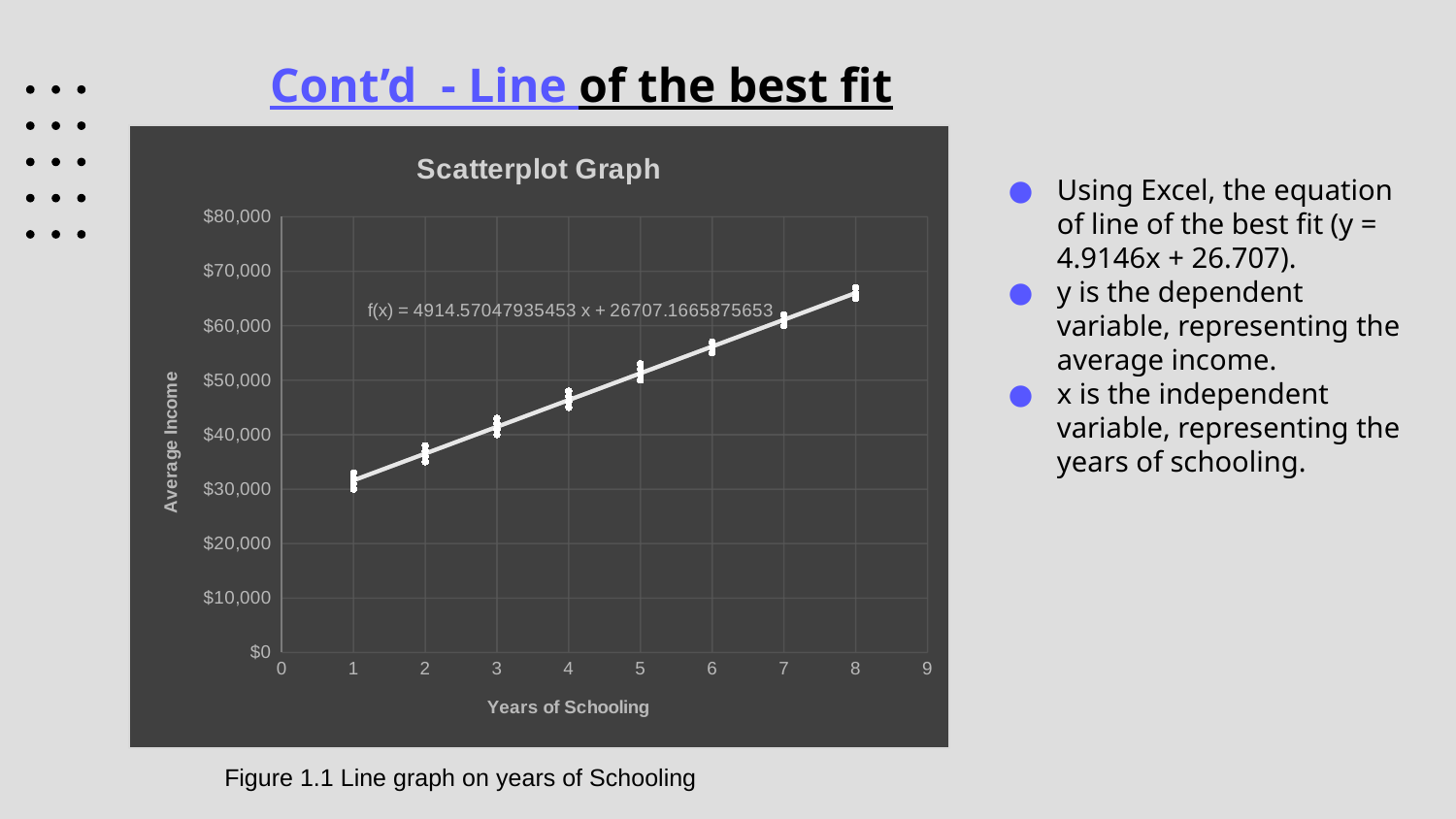
What kind of chart is shown on the slide? scatter chart Is the average income at 2 years of schooling greater or less than $40,000? less Do the values rise or fall as years of schooling increase? rise At which number of years of schooling is the average income lowest? 1 What is the title of the chart? Scatterplot Graph Which has the higher average income: 3 years of schooling or 7 years of schooling? 7 years of schooling Is the average income at 6 years of schooling greater or less than $60,000? less Is the average income at 8 years of schooling greater or less than $60,000? greater At which number of years of schooling is the average income highest? 8 What is the label of the x axis? Years of Schooling